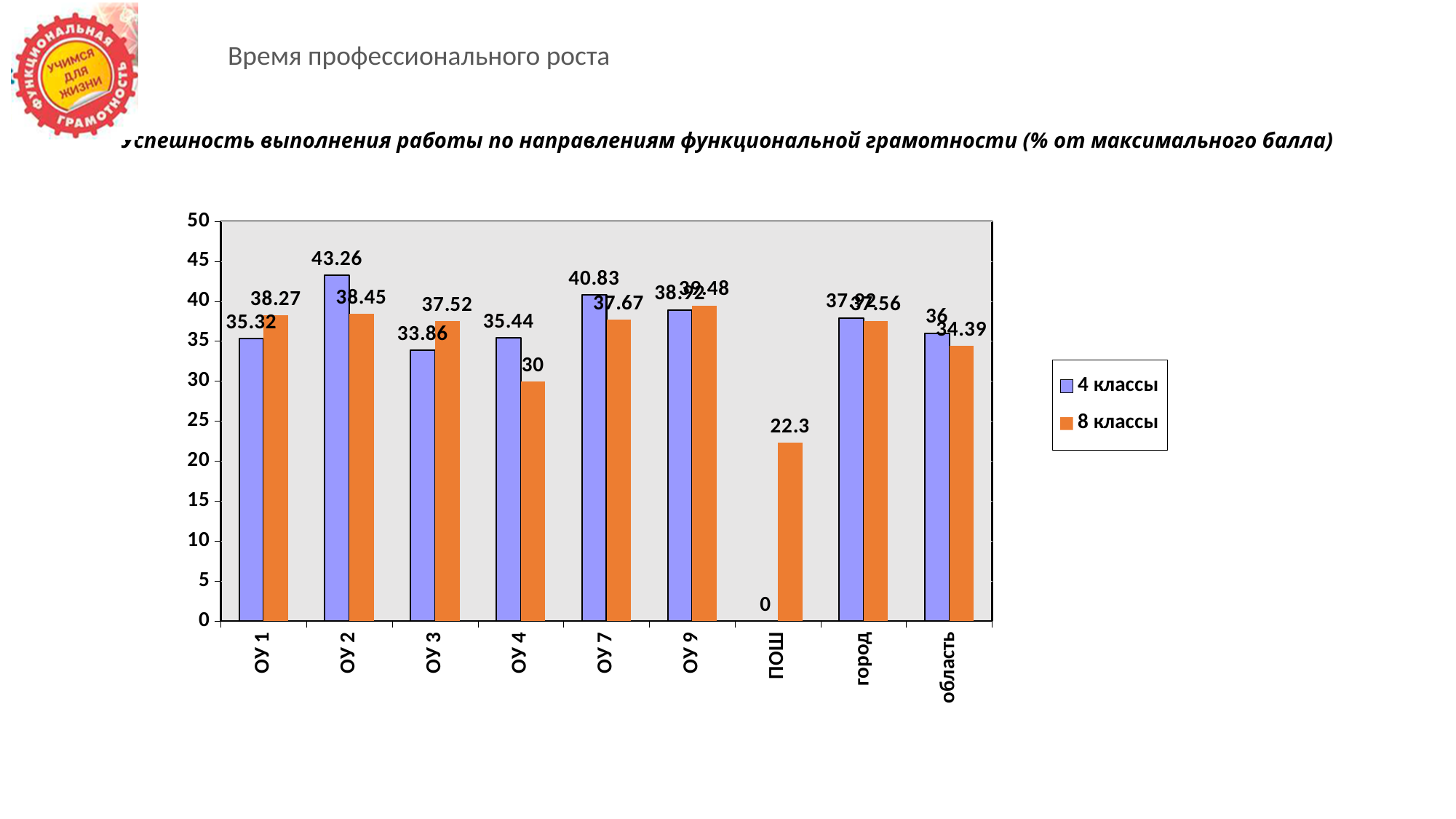
Which category has the highest value for 4 классы? ОУ 2 What is the difference between the 4 классы and 8 классы values at ОУ 4? 5.44 What are the two entries listed in the legend? 4 классы, 8 классы How many series does the legend list? 2 At ОУ 1, which series has the larger value, 4 классы or 8 классы? 8 классы How many categories are shown on the x axis? 9 What is the value for 4 классы at область? 36 What is the value for 8 классы at ОУ 4? 30 What kind of chart is shown on the slide? bar chart Which category has the lowest value for 8 классы? ПОШ What is the value for 4 классы at ОУ 2? 43.26 What is the value for 8 классы at ПОШ? 22.3